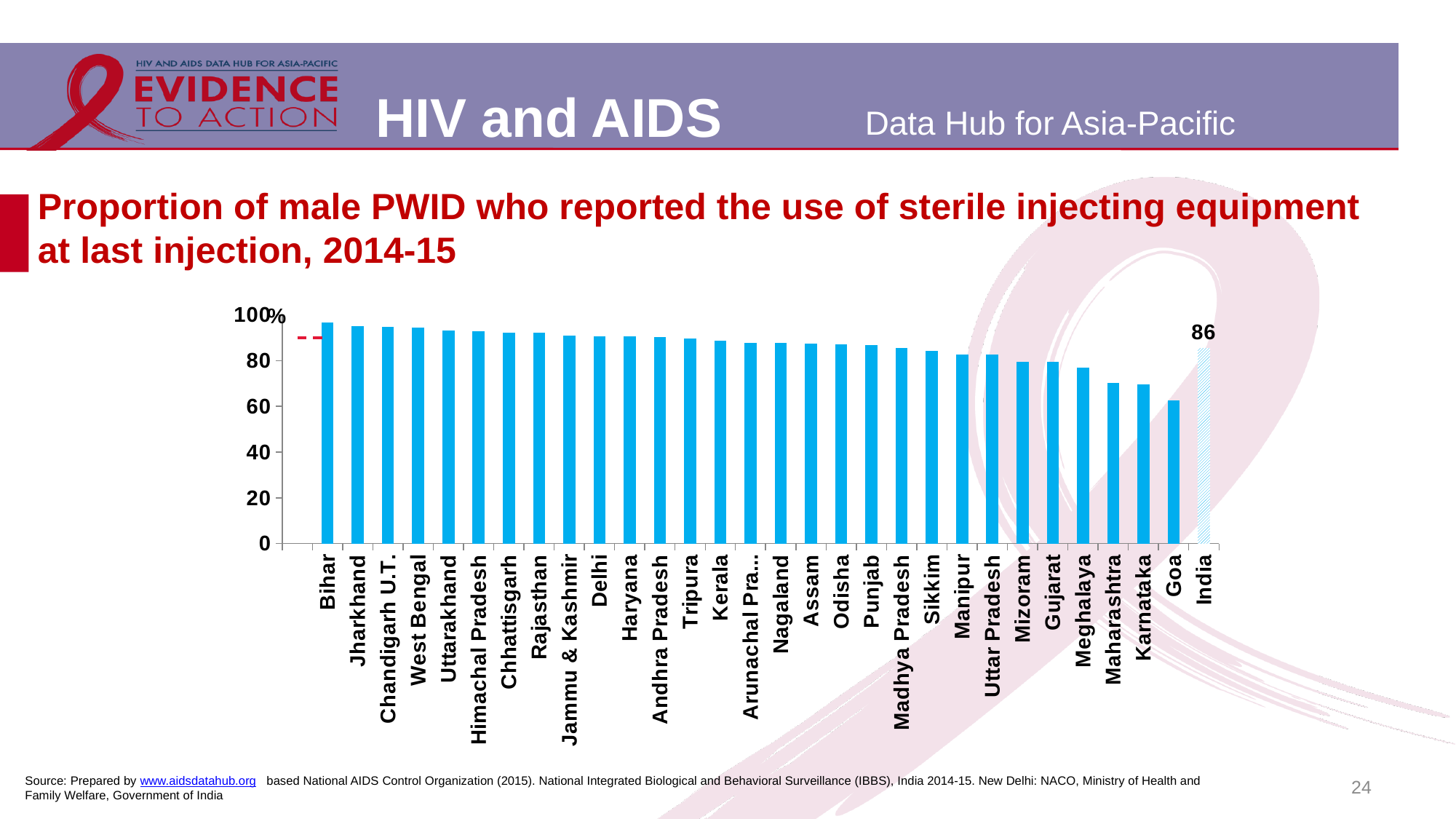
Is the value for Goa greater or less than 80? less What kind of chart is shown on the slide? Bar chart Do the bar values rise or fall from left to right across the states? Fall Which state has the lowest proportion of male PWID reporting use of sterile injecting equipment? Goa Which state has the highest proportion of male PWID reporting use of sterile injecting equipment? Bihar How many categories (bars) are shown on the chart? 30 Is the value for Maharashtra greater or less than 60? greater What value is labelled for India? 86 Which has a higher value, Meghalaya or Maharashtra? Meghalaya Which has a higher value, Bihar or Goa? Bihar Is the value for Bihar greater or less than 80? greater